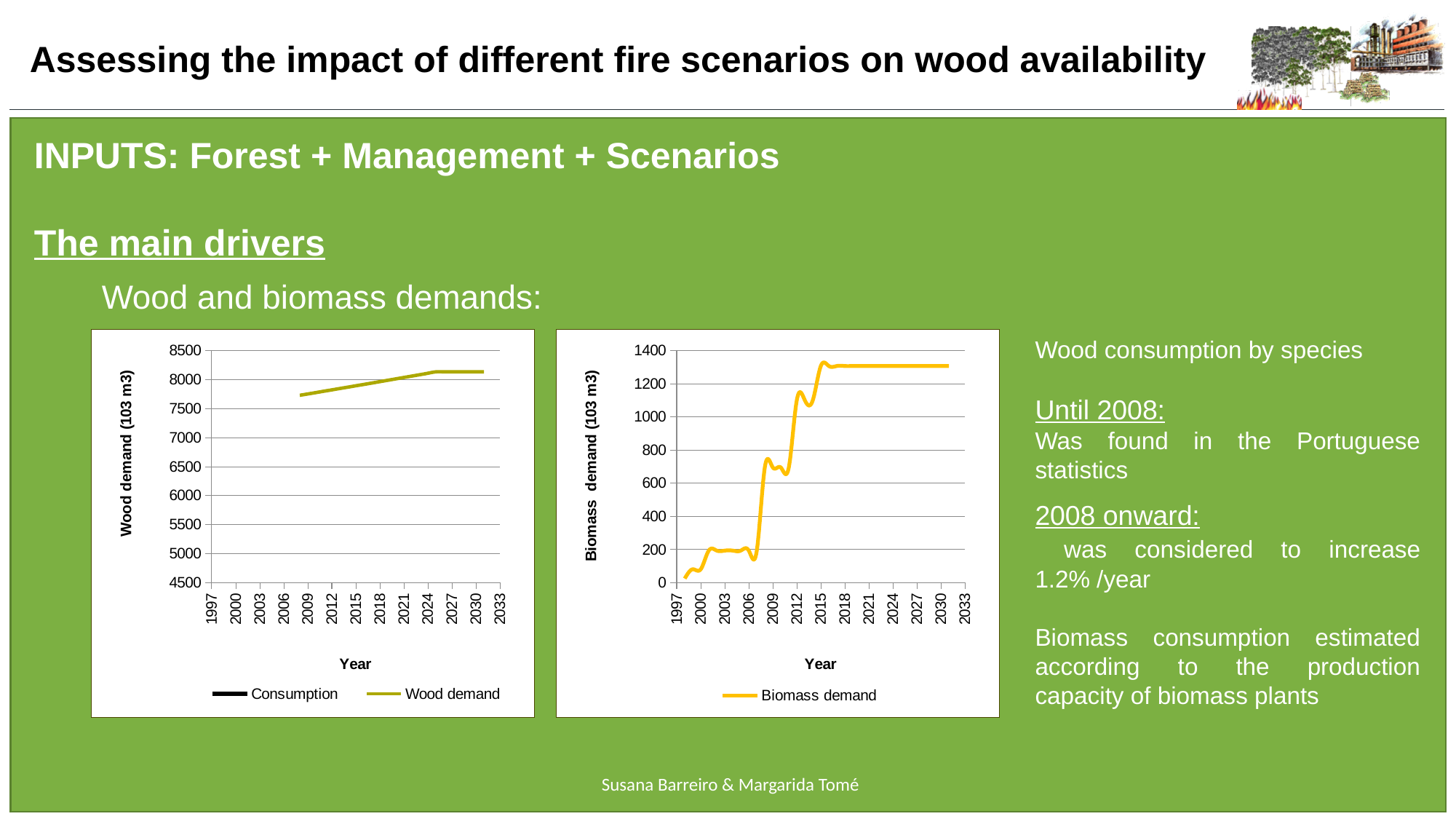
What are the two legend entries of the left chart? Consumption and Wood demand In the left chart, is the Wood demand value for 2030 greater or less than 8000? greater In the right chart, is the Biomass demand value for 2003 greater or less than 400? less In the right chart, is the Biomass demand value for 2030 greater or less than 1200? greater What kind of chart is the left chart (Wood demand)? line chart How many series does the legend of the left chart (Wood demand) list? 2 What kind of chart is the right chart (Biomass demand)? line chart What is the y-axis label of the right chart? Biomass demand (103 m3) How many series does the legend of the right chart (Biomass demand) list? 1 In the left chart, does the Wood demand line rise or fall from 2009 to 2024? rise In the right chart, does the Biomass demand line overall rise or fall from 1997 to 2018? rise